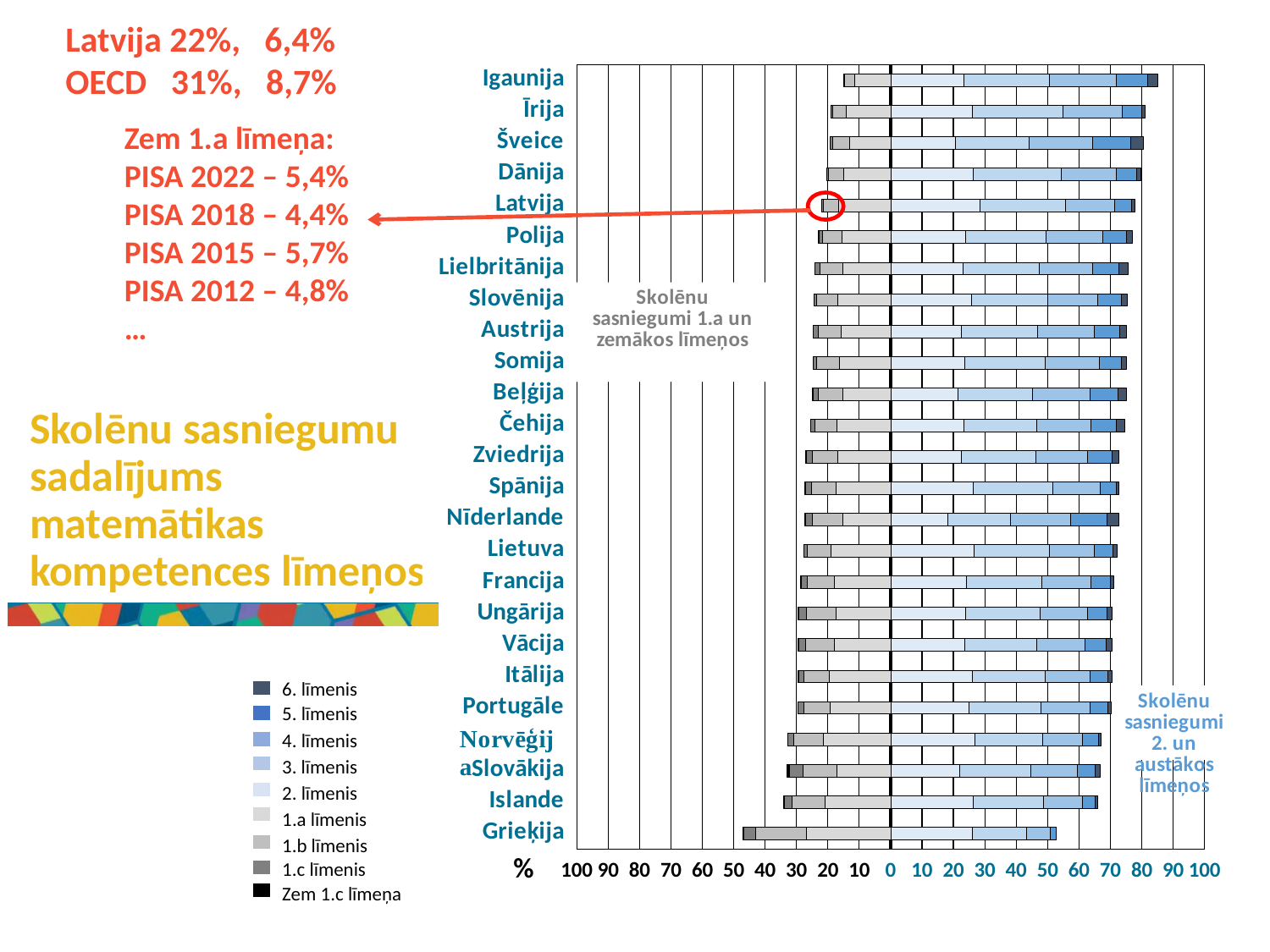
What kind of chart is shown on the slide? Stacked bar chart How many series does the legend list? 9 Is the share of students at level 2 and above for Grieķija greater or less than 60? less Is the share of students at level 1.a and below for Igaunija greater or less than 20? less Which country has the largest share of students at level 1.a and below (the bar extending furthest to the left)? Grieķija Which country appears at the top of the chart? Igaunija How many countries are listed on the chart's vertical axis? 25 Which country has a larger share of students at level 2 and above, Igaunija or Grieķija? Igaunija Which country has the smallest share of students at level 1.a and below (the shortest bar to the left of 0)? Igaunija Moving down the list of countries from Igaunija to Grieķija, does the share of students at level 1.a and below rise or fall? rise Is the share of students at level 1.a and below for Grieķija greater or less than 40? greater